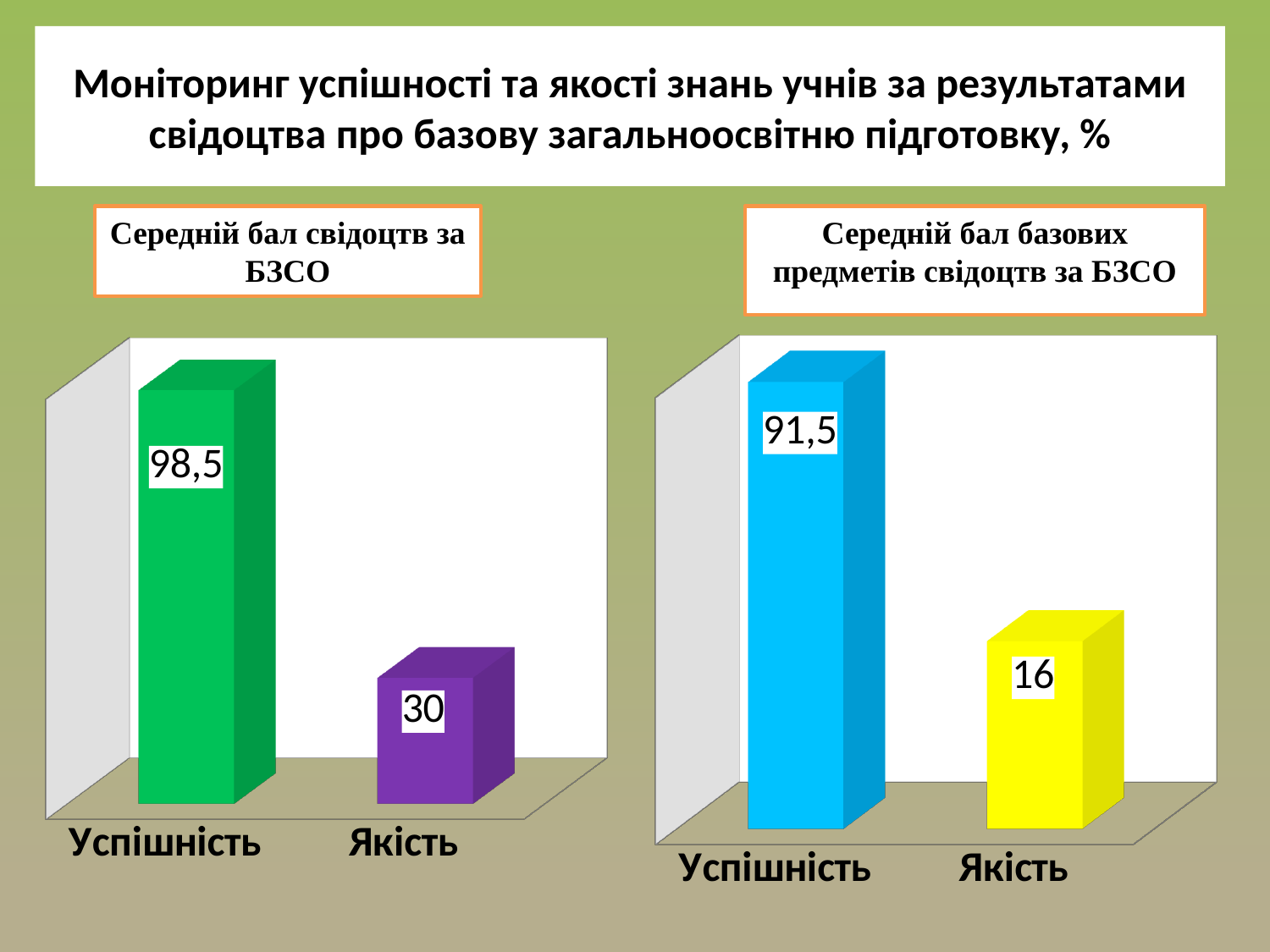
In the right chart (Середній бал базових предметів свідоцтв за БЗСО), which category has the lowest value? Якість Which is larger: Якість in the left chart or Якість in the right chart? Якість in the left chart In the left chart (Середній бал свідоцтв за БЗСО), what is the value for Успішність? 98,5 In the right chart (Середній бал базових предметів свідоцтв за БЗСО), what is the value for Якість? 16 What kind of chart is the right chart (Середній бал базових предметів свідоцтв за БЗСО)? Bar chart In the right chart (Середній бал базових предметів свідоцтв за БЗСО), what is the value for Успішність? 91,5 In the left chart (Середній бал свідоцтв за БЗСО), what is the value for Якість? 30 In the left chart (Середній бал свідоцтв за БЗСО), which category has the highest value? Успішність In the left chart (Середній бал свідоцтв за БЗСО), what is the difference between Успішність and Якість? 68,5 In the right chart (Середній бал базових предметів свідоцтв за БЗСО), what is the difference between Успішність and Якість? 75,5 In the right chart (Середній бал базових предметів свідоцтв за БЗСО), what colour is the Якість bar? Yellow How many categories are shown in the left chart (Середній бал свідоцтв за БЗСО)? 2